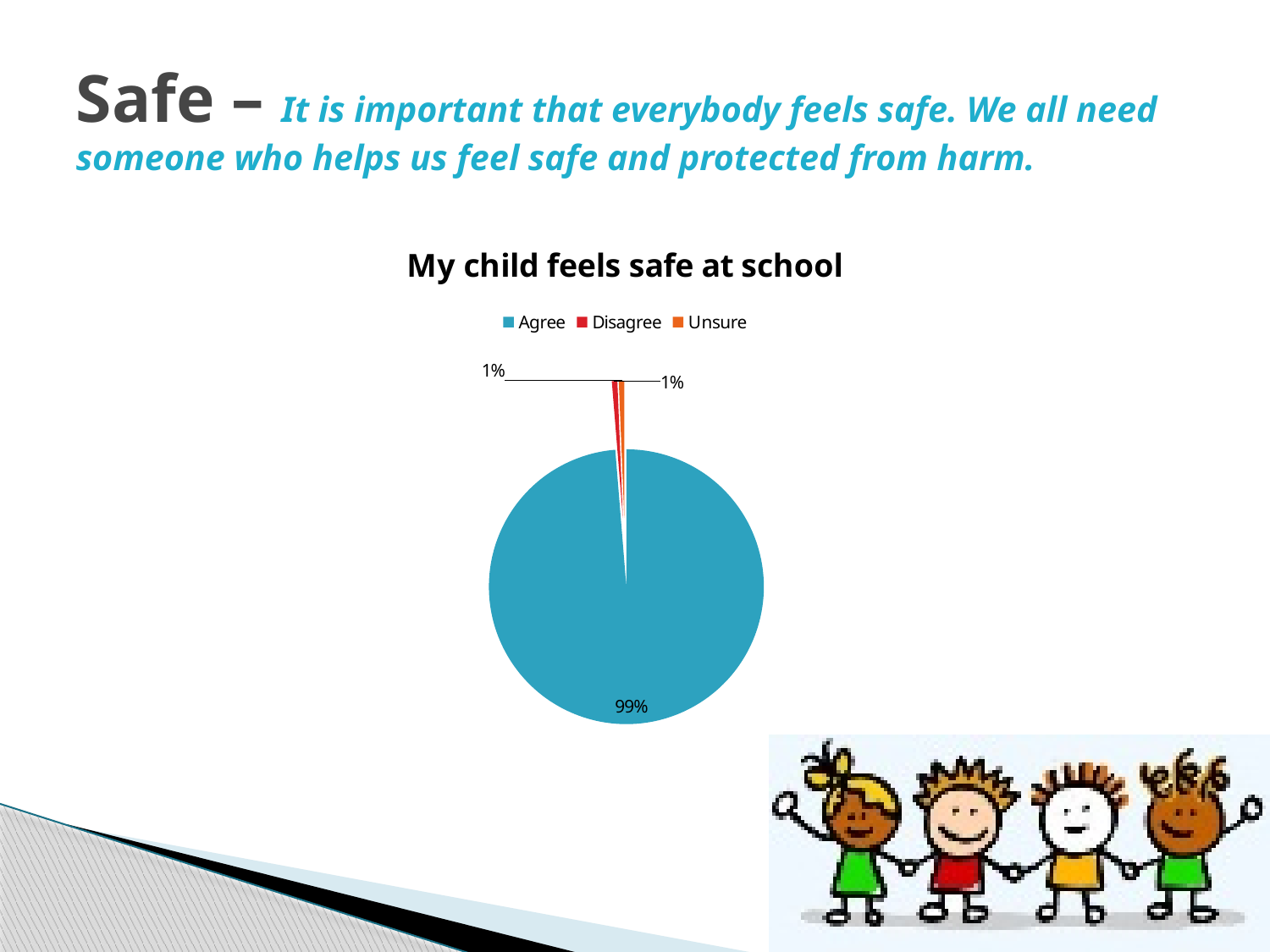
Which is larger, the Agree share or the Unsure share? Agree What type of chart is shown on the slide? pie chart How many slices does the pie chart have? 3 What percentage of respondents agree that their child feels safe at school? 99% What colour is the Agree slice? blue What is the difference between the Agree share and the Disagree share? 98% Which response has the largest share of the pie? Agree What percentage of respondents are unsure? 1% What is the combined share of Disagree and Unsure? 2% What is the title of the chart? My child feels safe at school What percentage of respondents disagree? 1% How many series does the legend list? 3